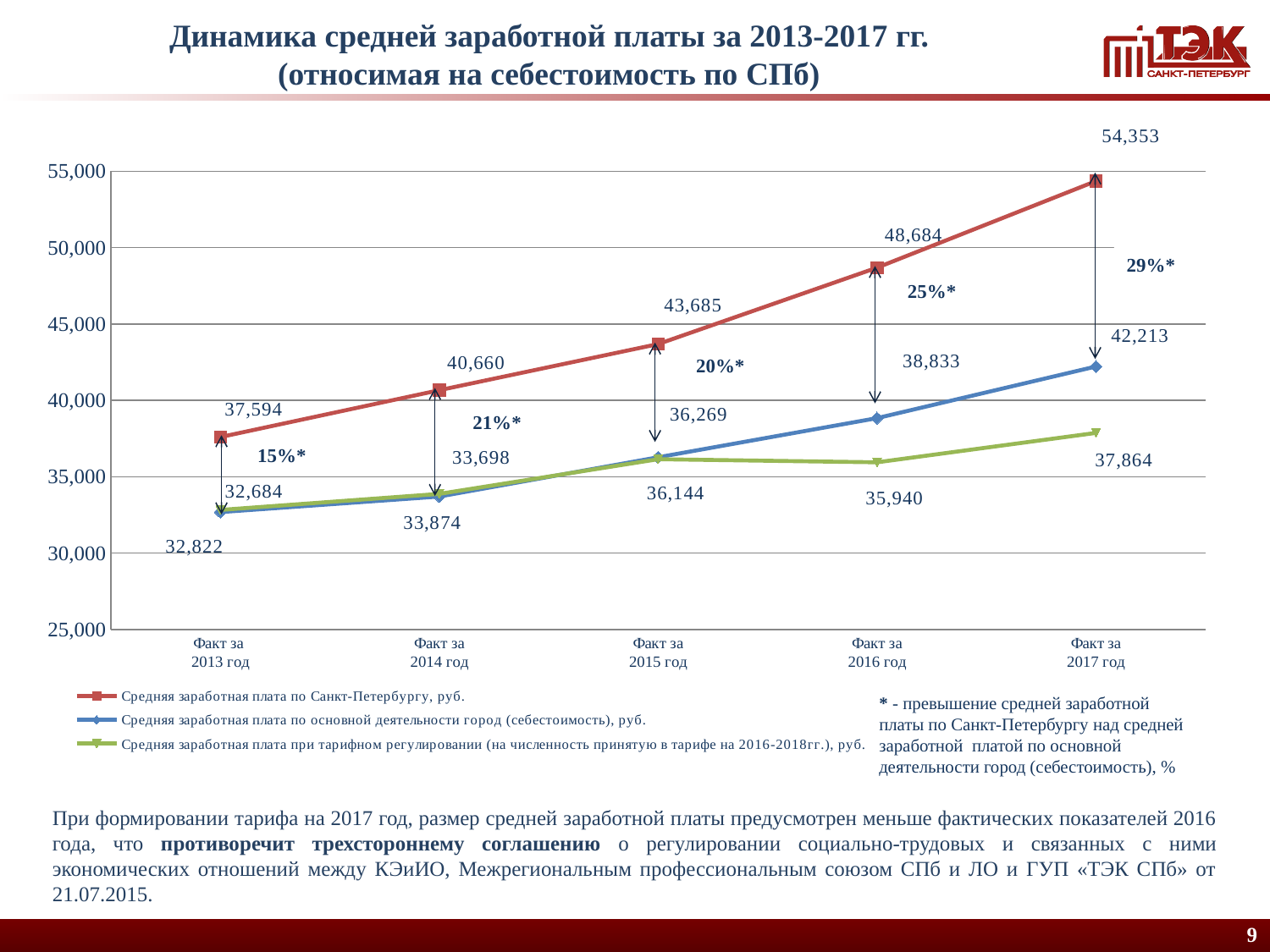
What percentage excess is marked with an asterisk for 'Факт за 2016 год'? 25%* Is the value of 'Средняя заработная плата по Санкт-Петербургу, руб.' for 'Факт за 2015 год' greater or less than 45,000? less What is the value of 'Средняя заработная плата по Санкт-Петербургу, руб.' for 'Факт за 2017 год'? 54,353 In which year is 'Средняя заработная плата по Санкт-Петербургу, руб.' the lowest? Факт за 2013 год For 'Факт за 2016 год', which is larger: 'Средняя заработная плата по основной деятельности город (себестоимость), руб.' or 'Средняя заработная плата при тарифном регулировании'? Средняя заработная плата по основной деятельности город (себестоимость), руб. How many series does the legend list? 3 What type of chart is shown on the slide? Line chart How many years (points) are plotted along the x axis? 5 What is the value of 'Средняя заработная плата по основной деятельности город (себестоимость), руб.' for 'Факт за 2016 год'? 38,833 What is the value of 'Средняя заработная плата при тарифном регулировании' for 'Факт за 2017 год'? 37,864 What is the difference between 'Средняя заработная плата по Санкт-Петербургу, руб.' and 'Средняя заработная плата по основной деятельности город (себестоимость), руб.' for 'Факт за 2017 год'? 12,140 Does 'Средняя заработная плата по Санкт-Петербургу, руб.' rise or fall from 2013 to 2017? Rise